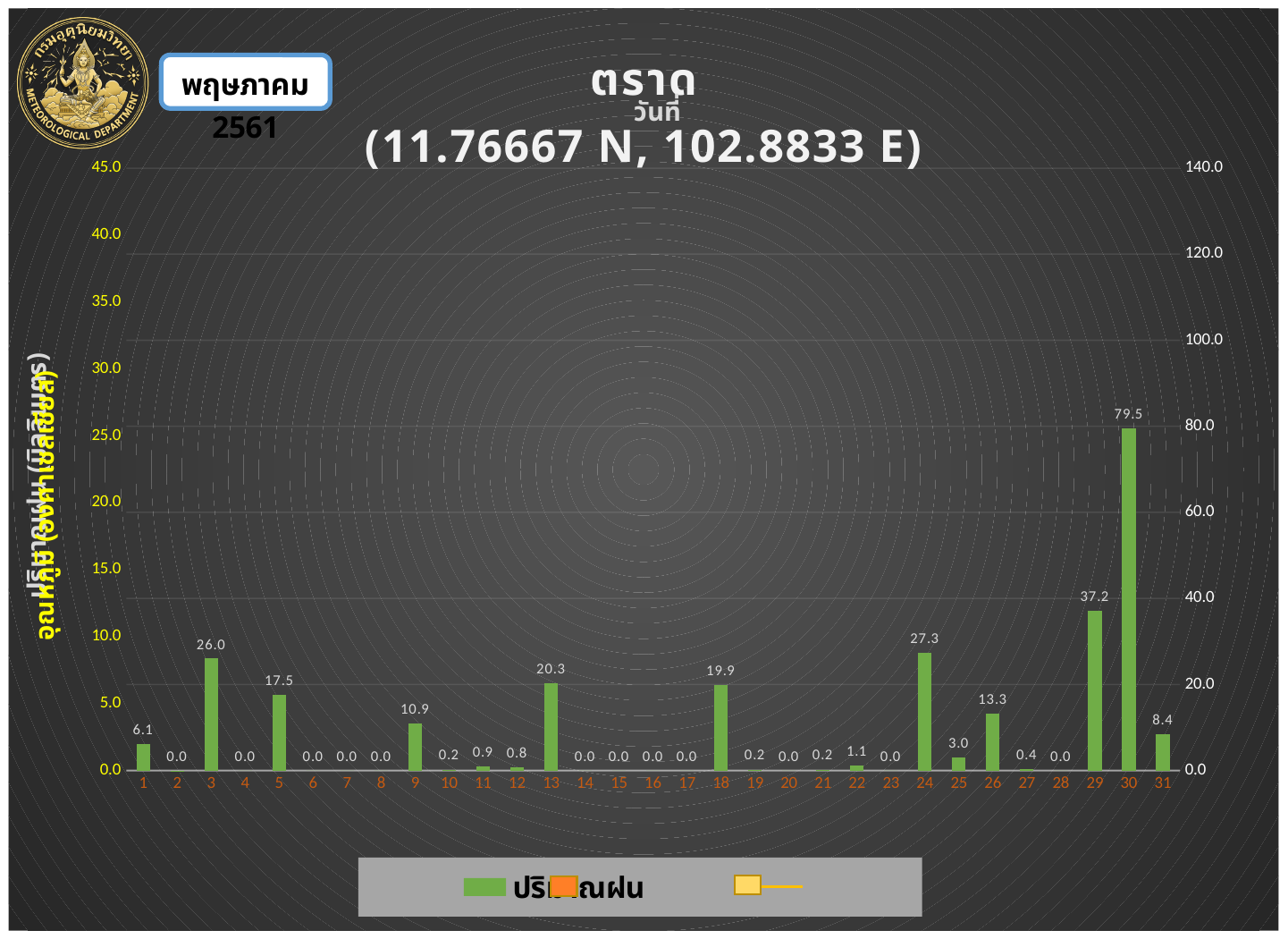
Which day has the highest rainfall value? 30 What is the difference between the rainfall values for day 24 and day 3? 1.3 What is the rainfall value for day 30? 79.5 Which day has the larger rainfall value, day 26 or day 31? 26 What is the rainfall value for day 24? 27.3 What is the rainfall value for day 13? 20.3 Which day has the larger rainfall value, day 3 or day 5? 3 What is the rainfall value for day 3? 26.0 How many days are shown on the x axis of the chart? 31 What is the difference between the rainfall values for day 30 and day 29? 42.3 What coordinates are given in the chart title? (11.76667 N, 102.8833 E) What type of chart is shown on the slide? bar chart